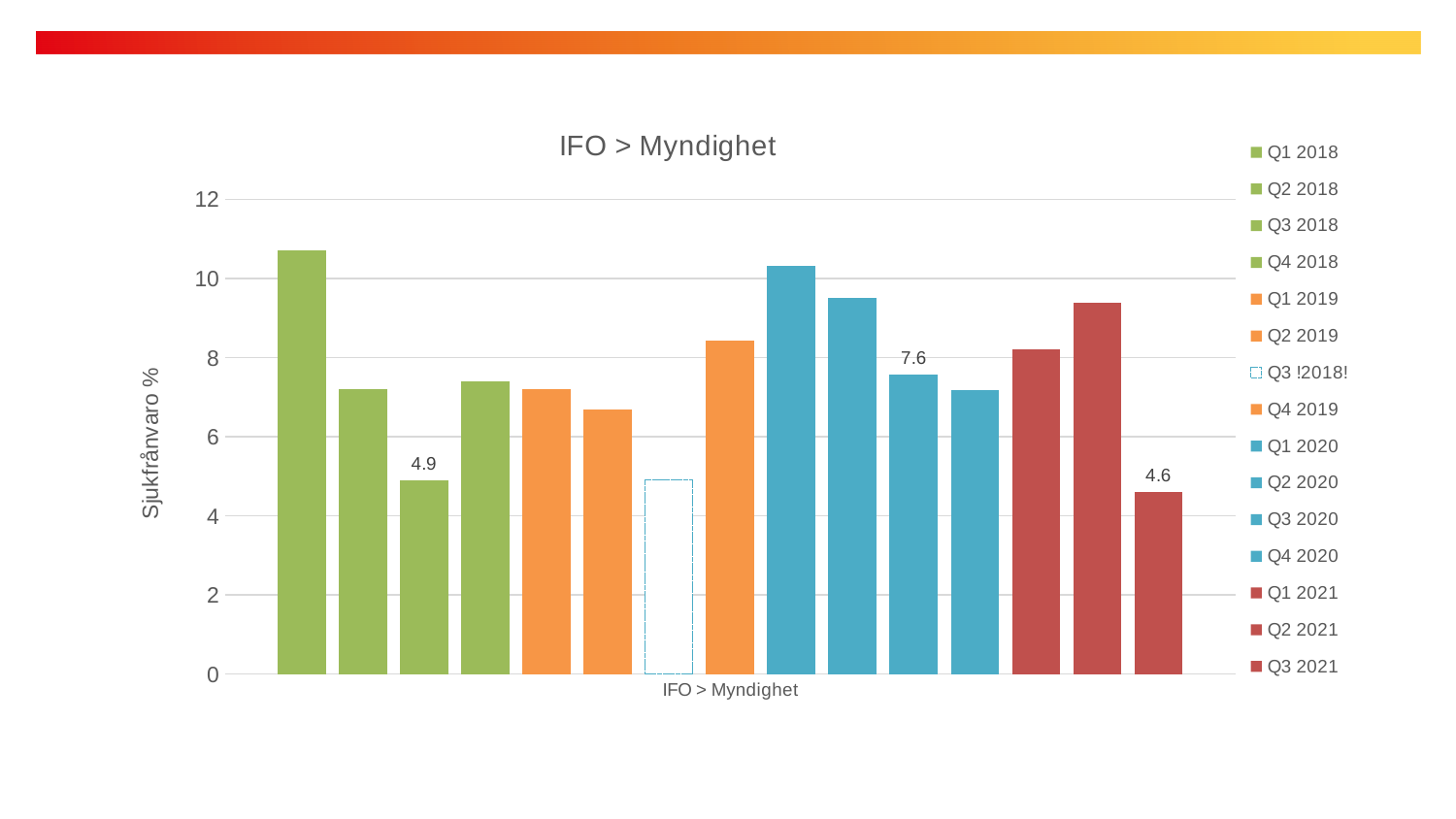
What is the difference between the values for Q3 2020 and Q3 2018? 2.7 Which series has the lowest value? Q3 2021 What is the value for Q3 2021? 4.6 Which is larger, the value for Q3 2020 or the value for Q3 2021? Q3 2020 How many series does the legend list? 15 Is the value for Q1 2018 greater or less than 10? greater What is the value for Q3 2020? 7.6 Which series has the highest value? Q1 2018 Is the value for Q2 2019 greater or less than 8? less What is the difference between the values for Q3 2018 and Q3 2021? 0.3 What kind of chart is shown on the slide? bar chart What is the value for Q3 2018? 4.9